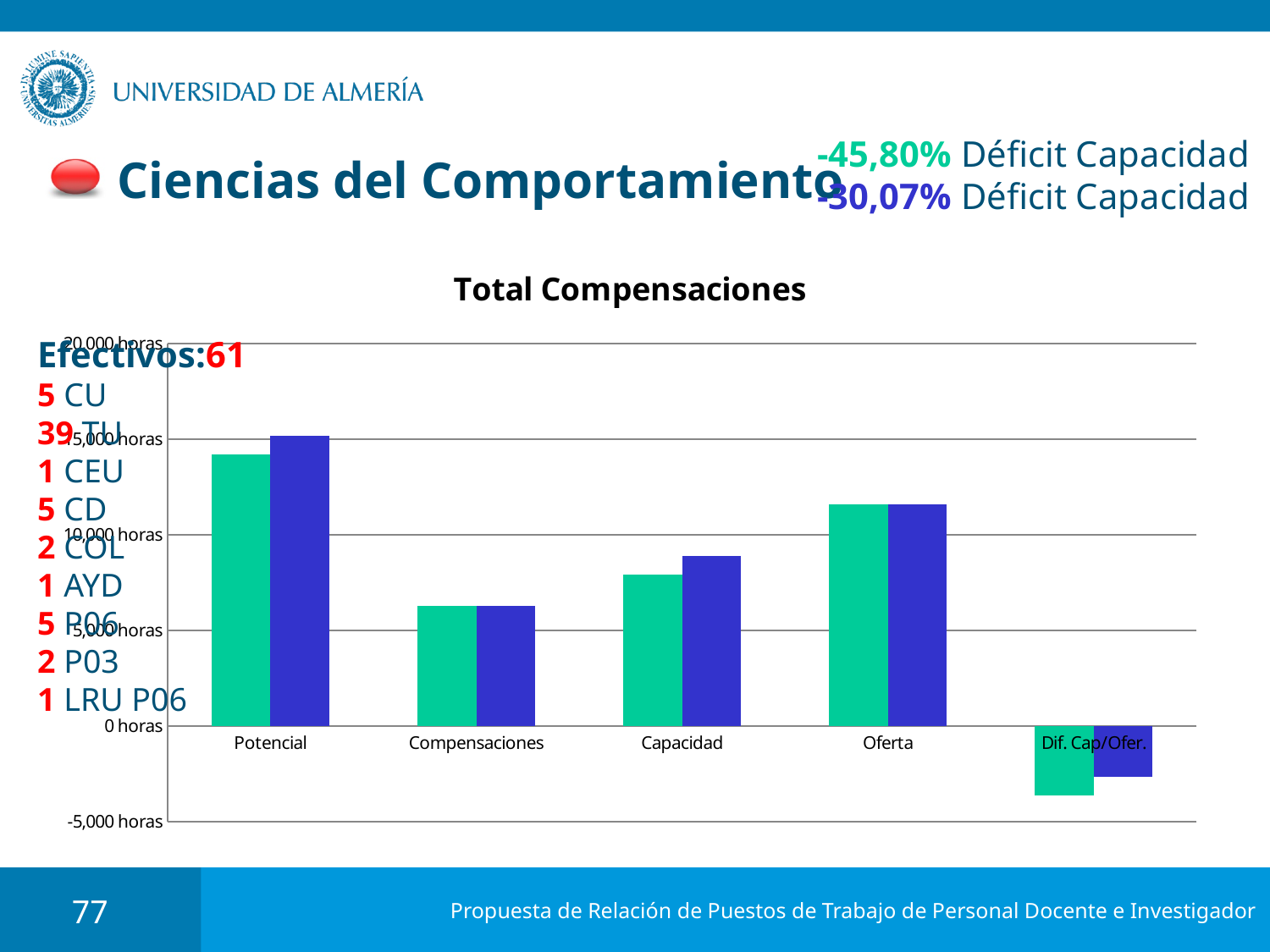
Is the value of the green bar for Potencial greater or less than 10,000 horas? greater What is the title of the chart? Total Compensaciones What kind of chart is shown on the slide? bar chart Which is larger, the blue bar for Compensaciones or the blue bar for Capacidad? Capacidad Which category has the lowest bars in the chart? Dif. Cap/Ofer. Is the value of the green bar for Dif. Cap/Ofer. greater or less than 0 horas? less Is the value of the green bar for Compensaciones greater or less than 10,000 horas? less Which category has the tallest bars in the chart? Potencial How many categories are shown on the x axis of the chart? 5 Which is larger, the green bar for Capacidad or the green bar for Oferta? Oferta